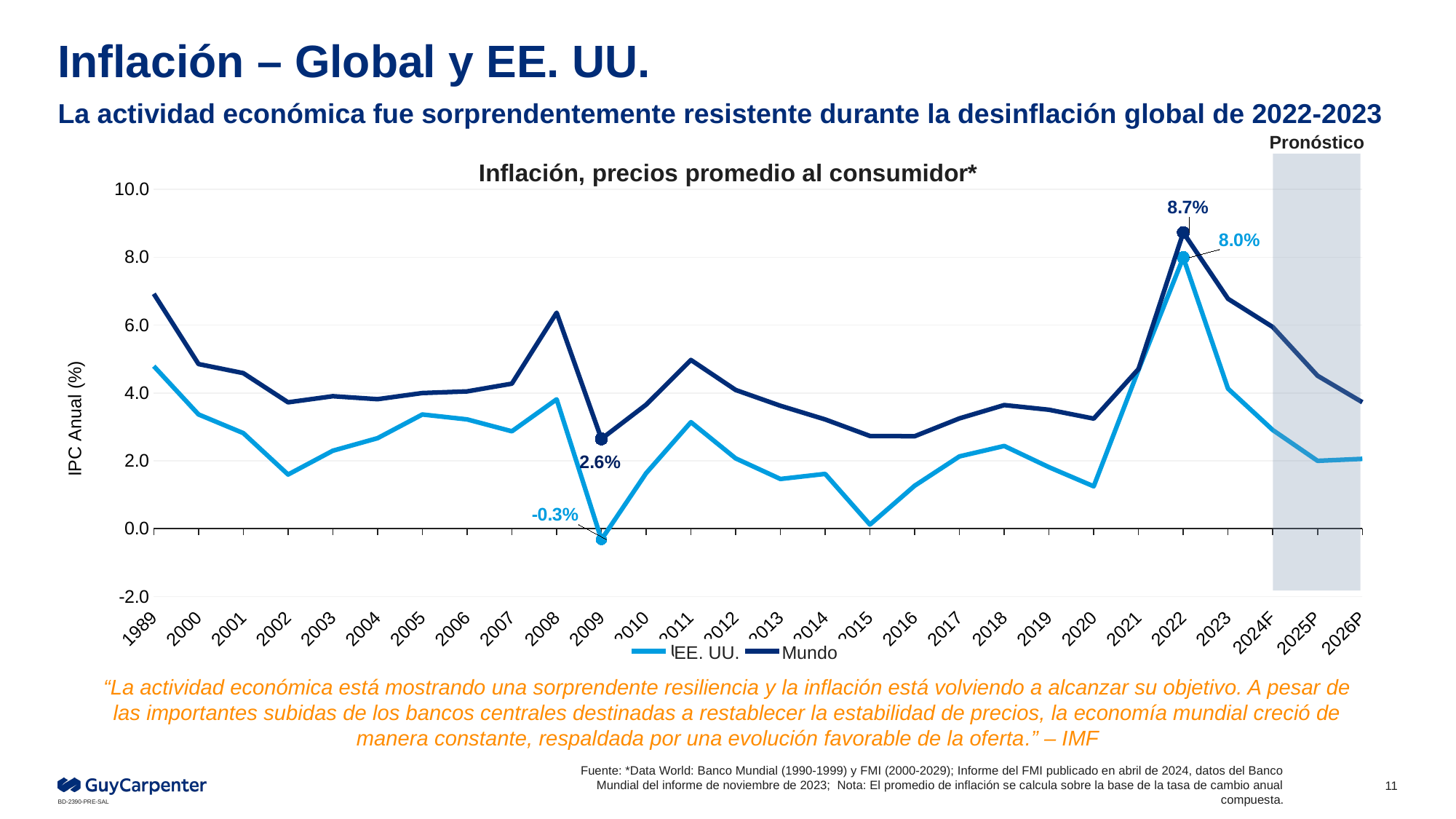
How many series does the legend list? 2 What is the value for Mundo in 2009? 2.6% In which year does the Mundo series reach its highest value? 2022 What is the value for EE. UU. in 2022? 8.0% In which year does the EE. UU. series reach its lowest value? 2009 Which series has the larger value in 2009, EE. UU. or Mundo? Mundo What is the value for Mundo in 2022? 8.7% What is the difference between the Mundo and EE. UU. values in 2022? 0.7% Is the value for Mundo in 1989 greater or less than 6.0? greater What kind of chart is shown on the slide? line chart What is the value for EE. UU. in 2009? -0.3% What is the title of the chart? Inflación, precios promedio al consumidor*